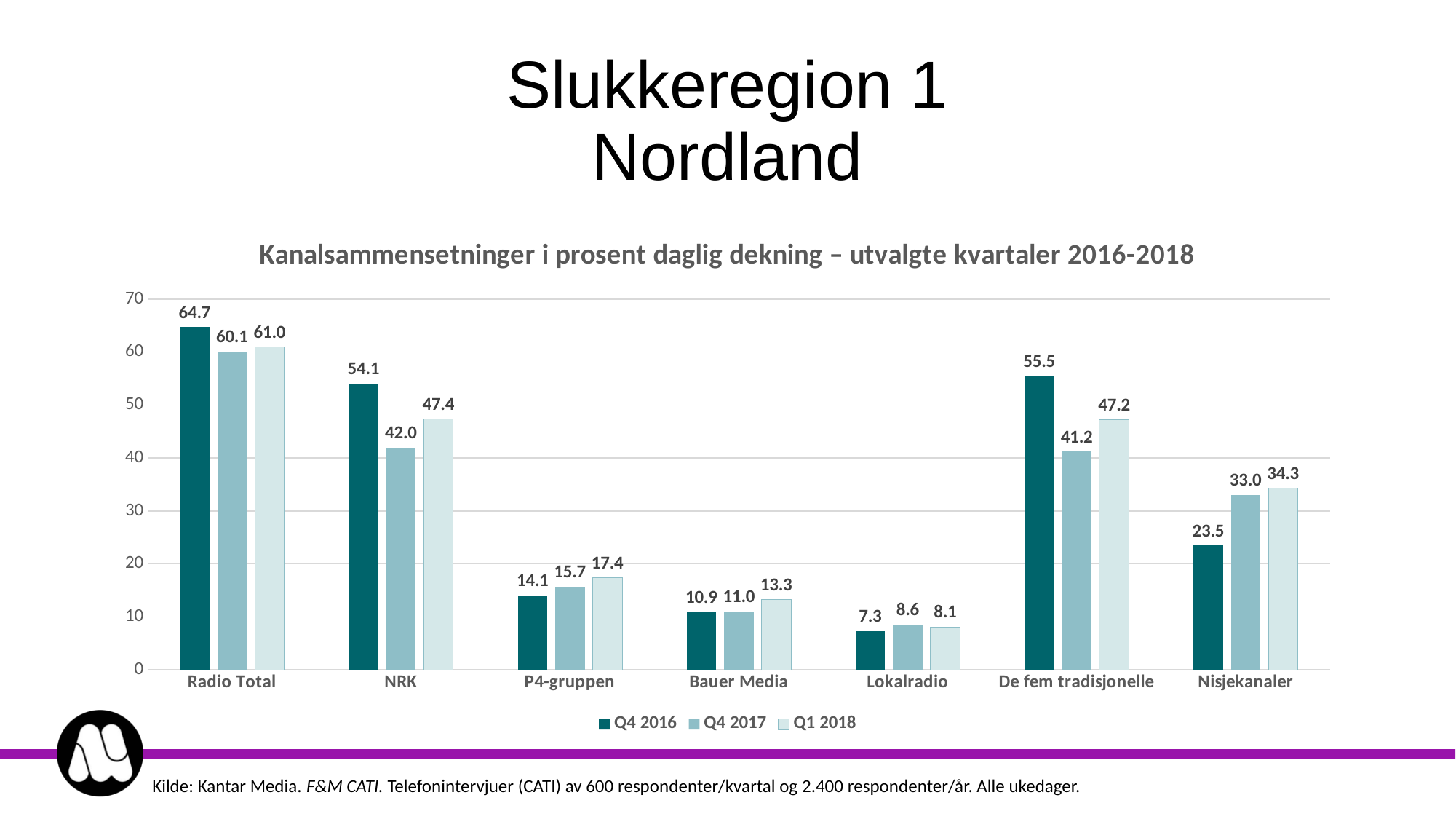
What is the value for Lokalradio in Q4 2016? 7.3 What is the value for NRK in Q4 2017? 42.0 What is the title of the chart? Kanalsammensetninger i prosent daglig dekning – utvalgte kvartaler 2016-2018 What is the value for Nisjekanaler in Q1 2018? 34.3 What is the difference between the Q4 2016 and Q1 2018 values for De fem tradisjonelle? 8.3 What kind of chart is shown on the slide? Bar chart Which category has the highest value in Q4 2016? Radio Total How many series does the legend list? 3 Do the values for P4-gruppen rise or fall from Q4 2016 to Q1 2018? Rise Which is larger for Bauer Media: the Q4 2017 value or the Q1 2018 value? Q1 2018 How many categories are shown on the x axis? 7 Which category has the lowest value in Q1 2018? Lokalradio